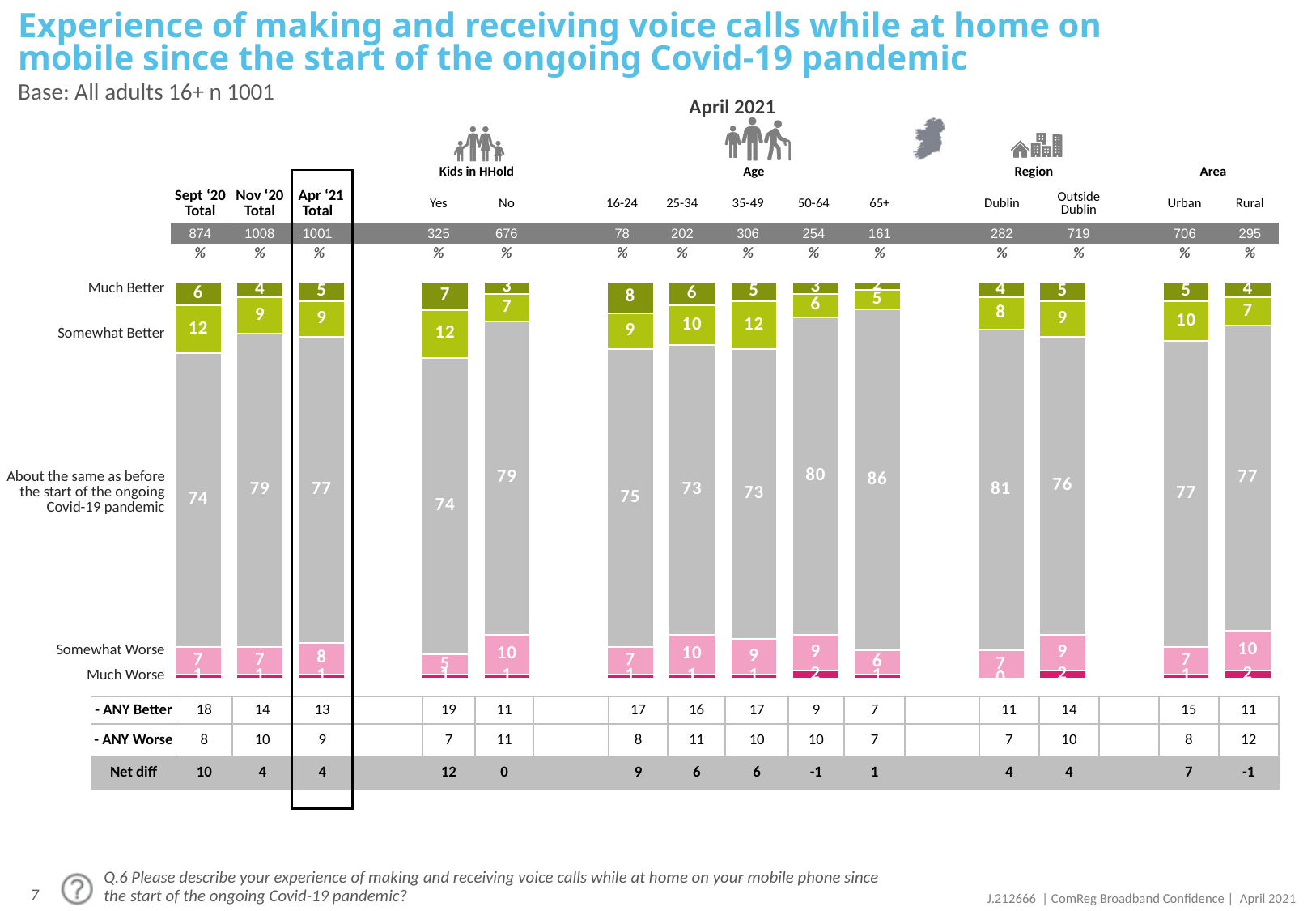
What is the Somewhat Better value for the Kids in HHold 'Yes' group? 12 What kind of chart is used on this slide? Stacked bar chart What is the Net diff for the Kids in HHold 'Yes' group? 12 What is the Somewhat Worse value for the Kids in HHold 'No' group? 10 Does the 'ANY Better' figure rise or fall across Sept '20, Nov '20 and Apr '21 Totals? Falls Among the age groups, which has the lowest Much Better value? 65+ Which has the larger 'About the same as before' value, Dublin or Outside Dublin? Dublin What is the Much Better value for the 16-24 age group? 8 Among the age groups, which has the highest 'About the same as before' value? 65+ How many stacked bars are shown in the chart? 14 What percentage of the Apr '21 Total said their experience was about the same as before the start of the pandemic? 77 How much higher is the Somewhat Worse value for Rural than for Urban? 3